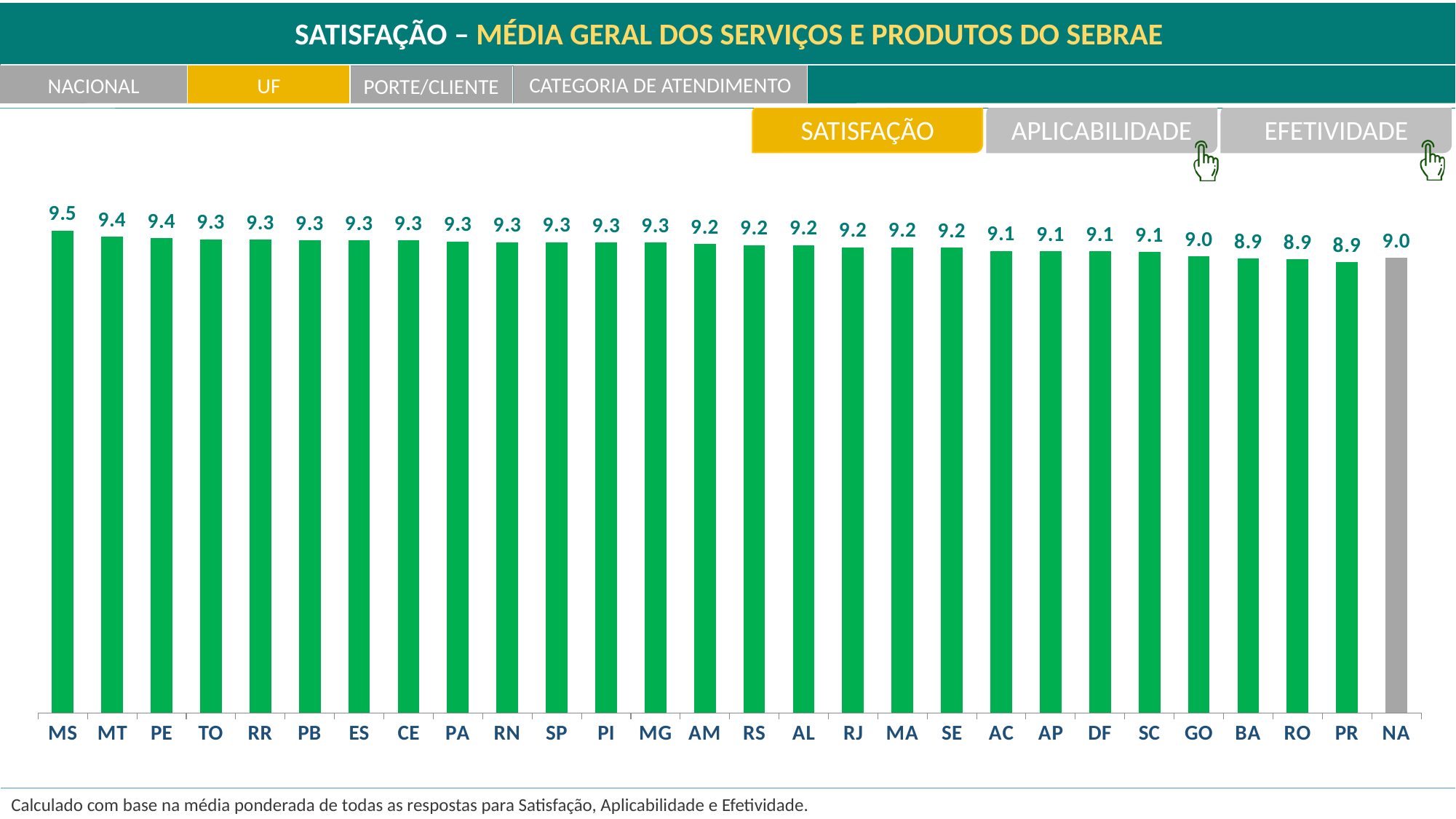
What is the satisfaction value for GO? 9.0 What is the difference between the values for MS and NA? 0.5 What is the value shown for NA (the national bar)? 9.0 Which has a higher satisfaction value, MT or BA? MT Do the state values generally rise or fall from left to right along the x axis? Fall What is the satisfaction value for SC? 9.1 Which state has the highest satisfaction value? MS What is the difference between the values for MS and PR? 0.6 What kind of chart is shown on the slide? Bar chart What is the satisfaction value for MS? 9.5 What is the lowest satisfaction value shown on the chart? 8.9 How many bars are shown on the chart? 28